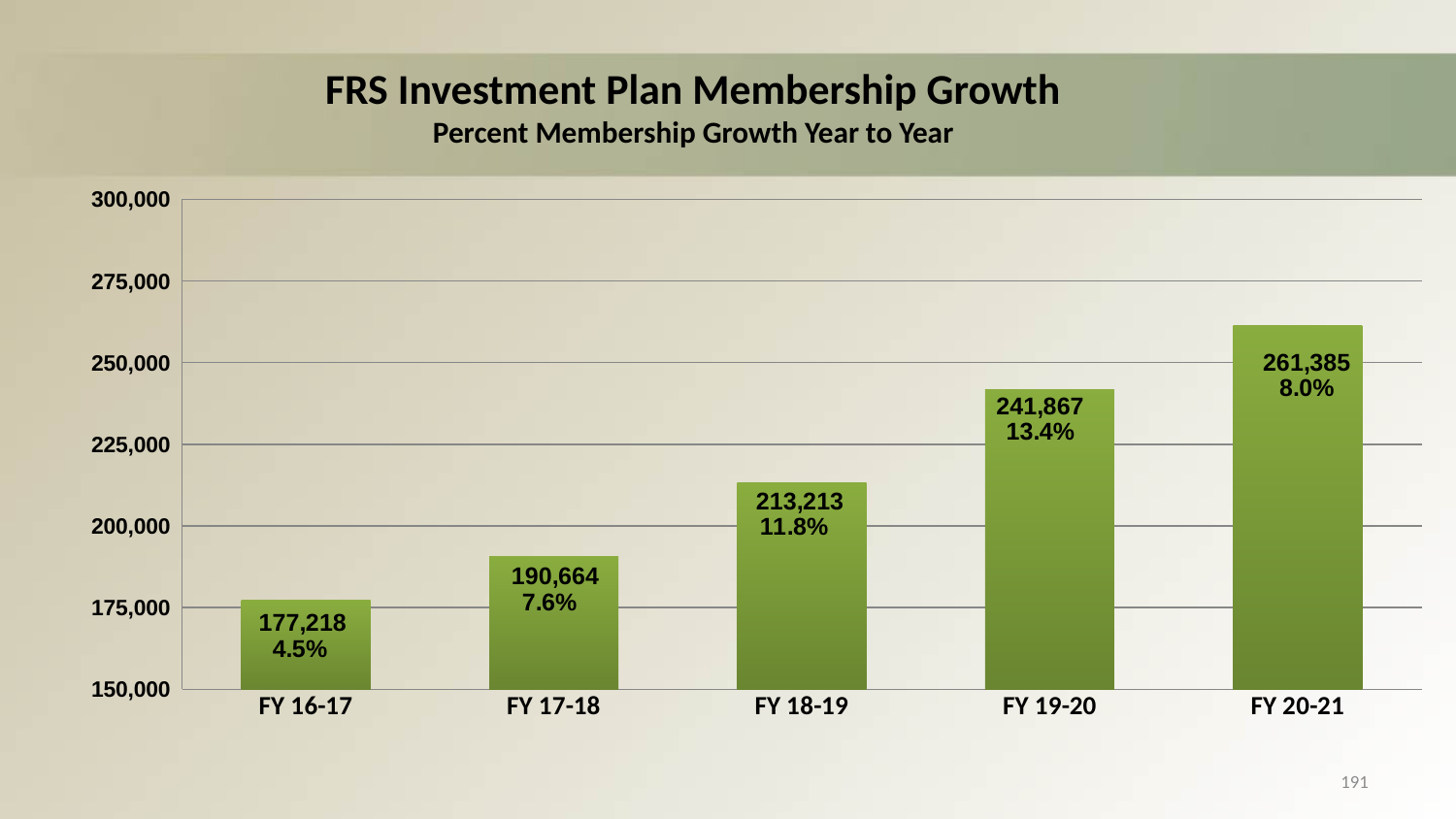
Is the membership value for FY 19-20 greater or less than 225,000? greater What is the difference in membership between FY 20-21 and FY 19-20? 19,518 Which fiscal year has the lowest membership? FY 16-17 Which fiscal year has the highest membership? FY 20-21 What percent growth is shown for FY 19-20? 13.4% What is the membership value for FY 16-17? 177,218 What is the title of the chart? FRS Investment Plan Membership Growth What is the membership value for FY 18-19? 213,213 What kind of chart is shown on the slide? bar chart Do the membership values rise or fall from FY 16-17 to FY 20-21? rise How many fiscal years are shown on the chart? 5 Which is larger, the membership for FY 17-18 or FY 18-19? FY 18-19